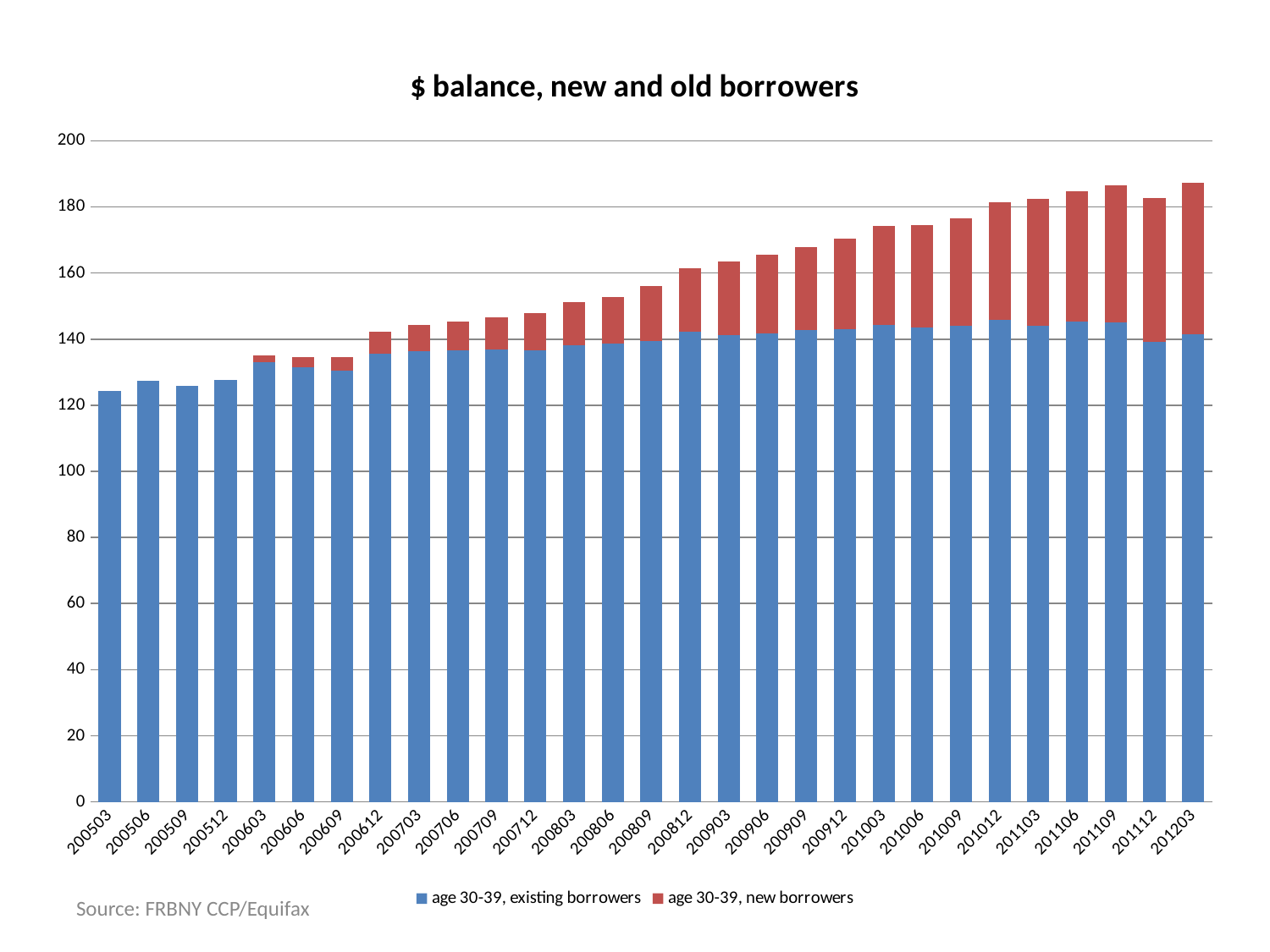
Is the value for age 30-39, existing borrowers at 200503 greater or less than 140? less Which colour represents age 30-39, new borrowers? red What kind of chart is shown on the slide? bar chart Is the total bar height for 200809 greater or less than 160? less Is the value for age 30-39, existing borrowers at 201012 greater or less than 140? greater Which has the larger total bar height, 200503 or 201203? 201203 Do the total bar heights generally rise or fall from 200503 to 201203? rise How many series does the legend list? 2 What is the title of the chart? $ balance, new and old borrowers Which has the larger value for age 30-39, existing borrowers, 200509 or 201106? 201106 How many time periods are shown on the x axis? 29